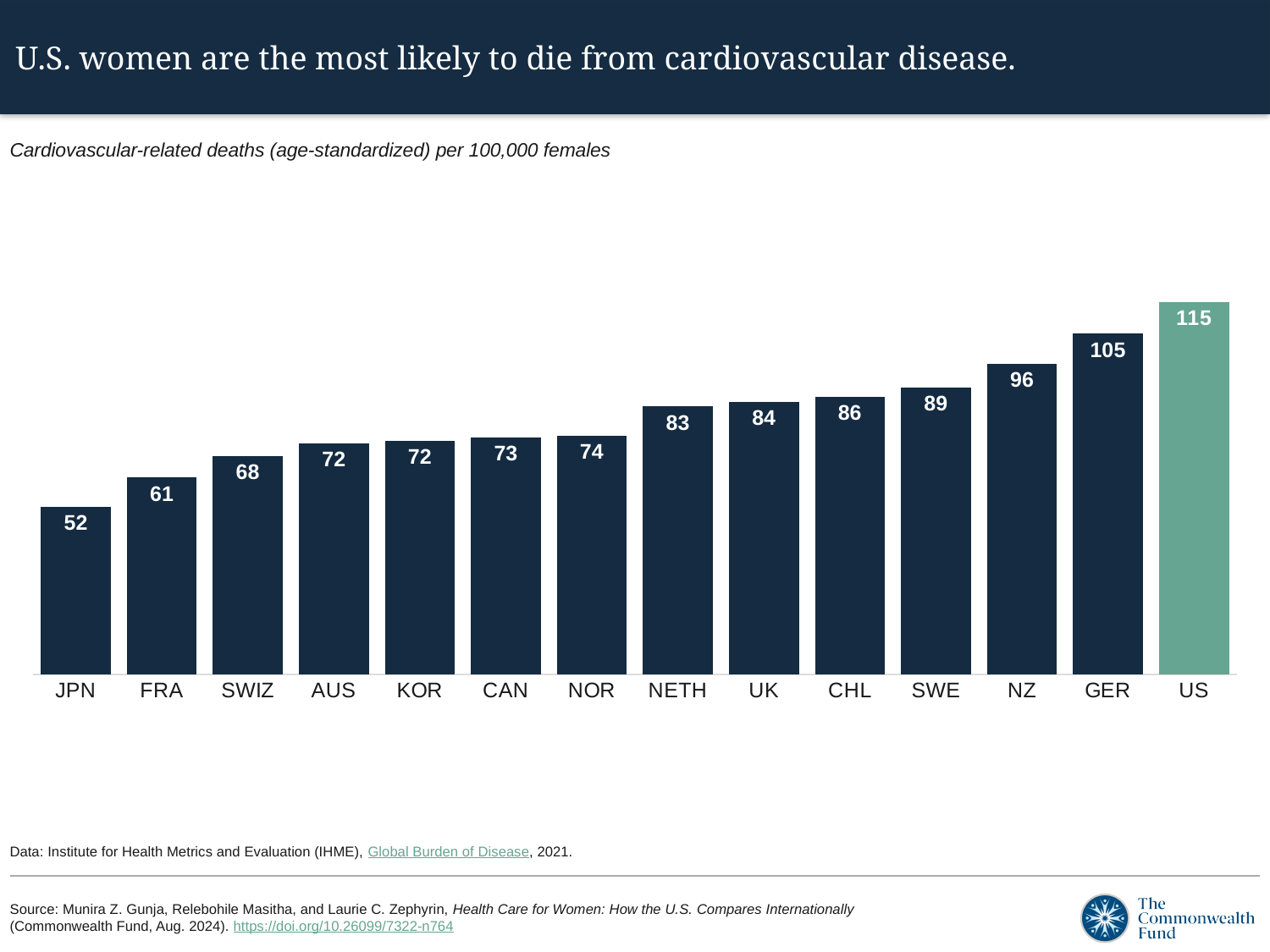
How many countries are shown in the chart? 14 Which bar is shown in a different colour from the others? US What is the value for JPN? 52 Which country has the highest value? US What is the difference between the values for the US and GER? 10 What kind of chart is this? Bar chart Which has a larger value, SWE or CHL? SWE Which country has the lowest value? JPN What is the value for NETH? 83 What is the value for the US? 115 Do the values rise or fall from left to right along the x axis? Rise What is the difference between the values for the US and JPN? 63